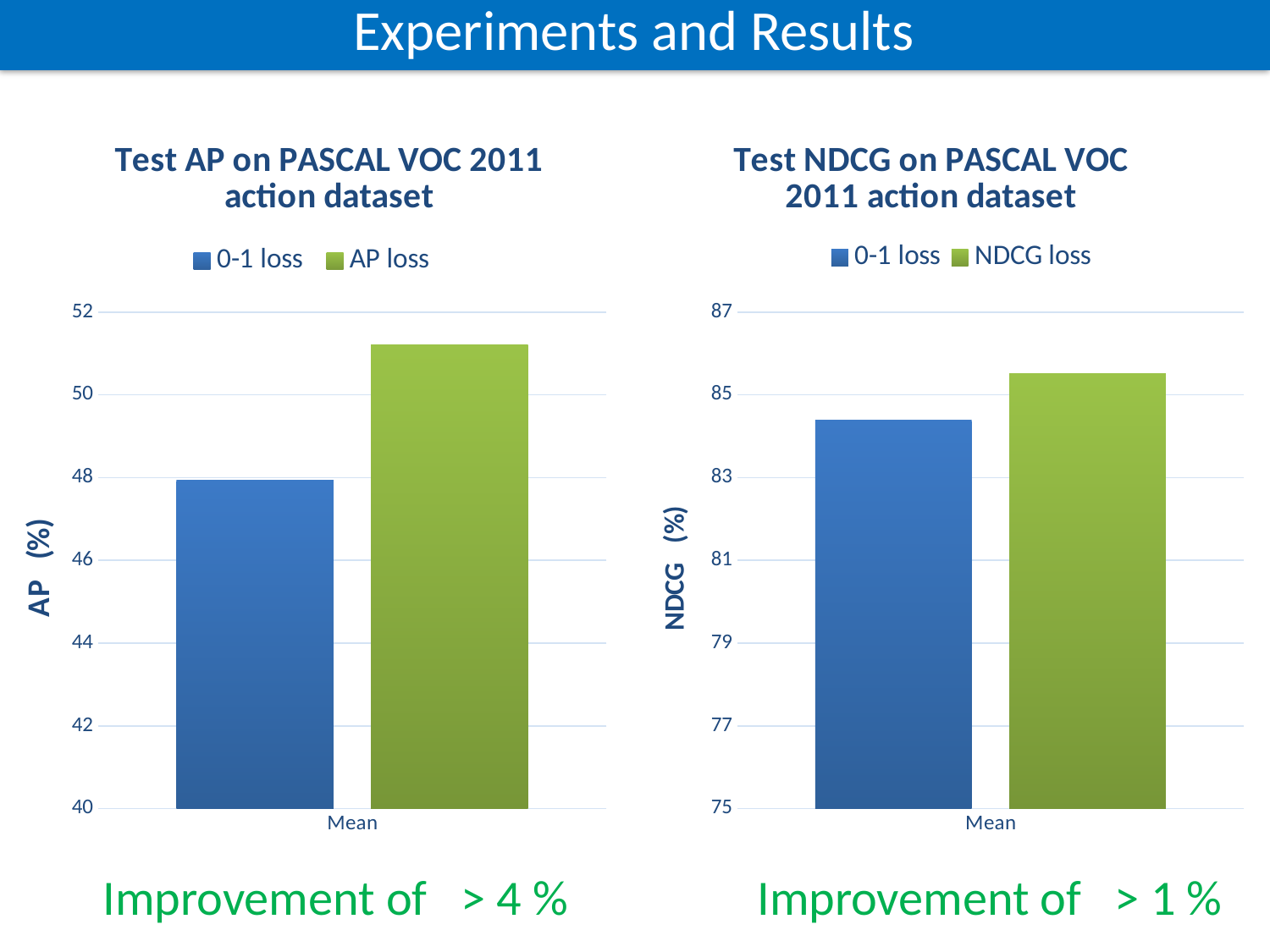
In the 'Test AP on PASCAL VOC 2011 action dataset' chart, what is the label on the x axis category? Mean In the 'Test AP on PASCAL VOC 2011 action dataset' chart, which series has the higher bar? AP loss In the 'Test AP on PASCAL VOC 2011 action dataset' chart, is the value for 0-1 loss greater or less than 46? greater In the 'Test NDCG on PASCAL VOC 2011 action dataset' chart, which series has the lower bar? 0-1 loss In the 'Test AP on PASCAL VOC 2011 action dataset' chart, how many series does the legend list? 2 In the 'Test NDCG on PASCAL VOC 2011 action dataset' chart, what is the y-axis label? NDCG (%) How many charts are shown on the slide? 2 In the 'Test AP on PASCAL VOC 2011 action dataset' chart, is the value for AP loss greater or less than 50? greater In the 'Test AP on PASCAL VOC 2011 action dataset' chart, what kind of chart is shown? bar chart In the 'Test NDCG on PASCAL VOC 2011 action dataset' chart, is the value for NDCG loss greater or less than 87? less In the 'Test NDCG on PASCAL VOC 2011 action dataset' chart, how many series does the legend list? 2